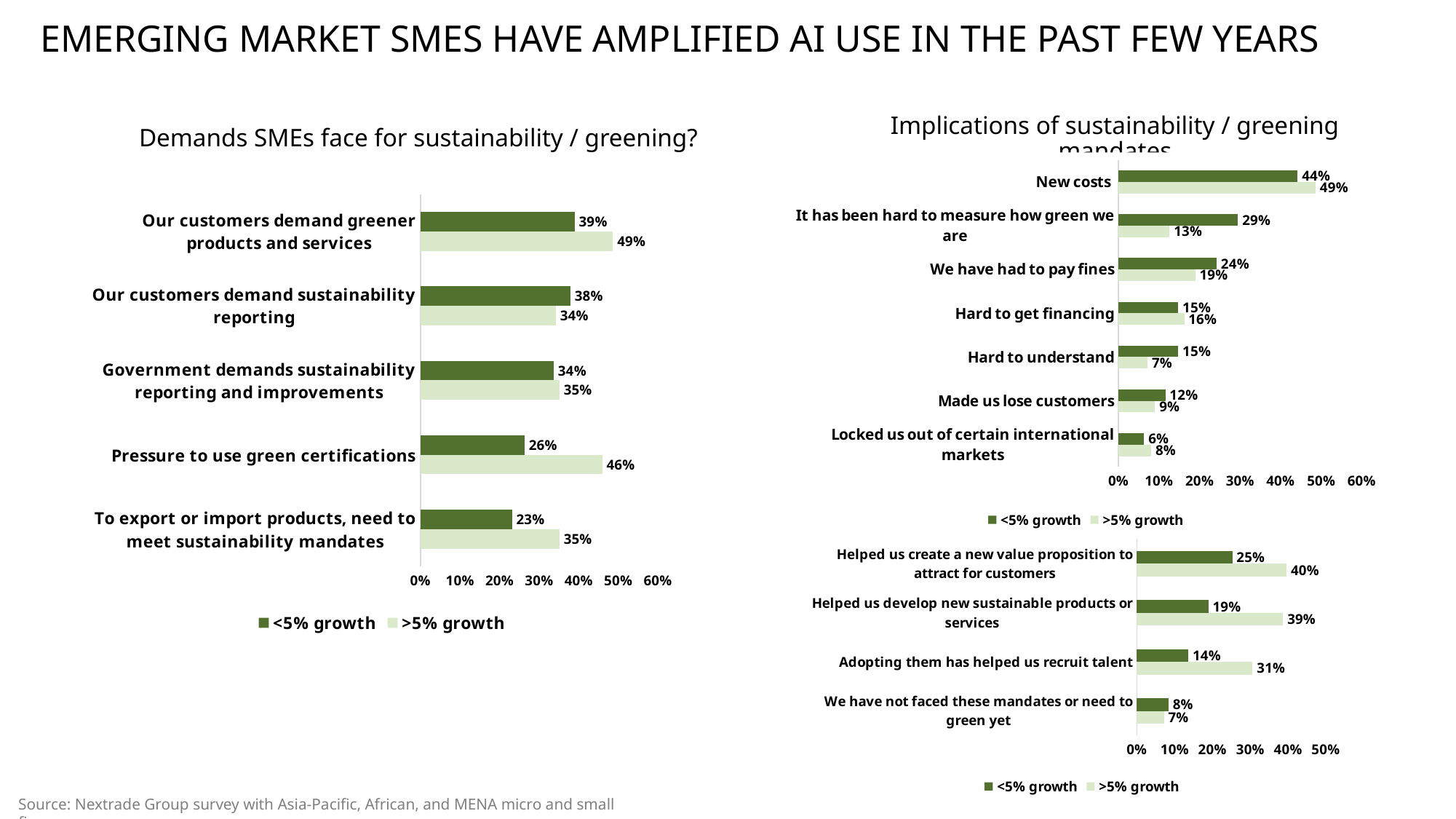
In the top-right chart titled 'Implications of sustainability / greening mandates', which is larger for 'It has been hard to measure how green we are': the '<5% growth' value or the '>5% growth' value? <5% growth In the top-right chart titled 'Implications of sustainability / greening mandates', which category has the lowest '<5% growth' value? Locked us out of certain international markets In the chart titled 'Demands SMEs face for sustainability / greening?', what is the value for '>5% growth' for 'Pressure to use green certifications'? 46% How many series does the legend of the bottom-right chart list? 2 In the chart titled 'Demands SMEs face for sustainability / greening?', which category has the highest '<5% growth' value? Our customers demand greener products and services In the chart titled 'Demands SMEs face for sustainability / greening?', what is the difference between the '>5% growth' and '<5% growth' values for 'Pressure to use green certifications'? 20% How many categories are shown in the top-right chart titled 'Implications of sustainability / greening mandates'? 7 In the bottom-right chart, what is the difference between the '>5% growth' and '<5% growth' values for 'Helped us develop new sustainable products or services'? 20% How many categories are shown in the chart titled 'Demands SMEs face for sustainability / greening?'? 5 In the top-right chart titled 'Implications of sustainability / greening mandates', what is the '>5% growth' value for 'New costs'? 49% In the chart titled 'Demands SMEs face for sustainability / greening?', what is the value for '<5% growth' for 'To export or import products, need to meet sustainability mandates'? 23% In the bottom-right chart, what is the '>5% growth' value for 'Adopting them has helped us recruit talent'? 31%